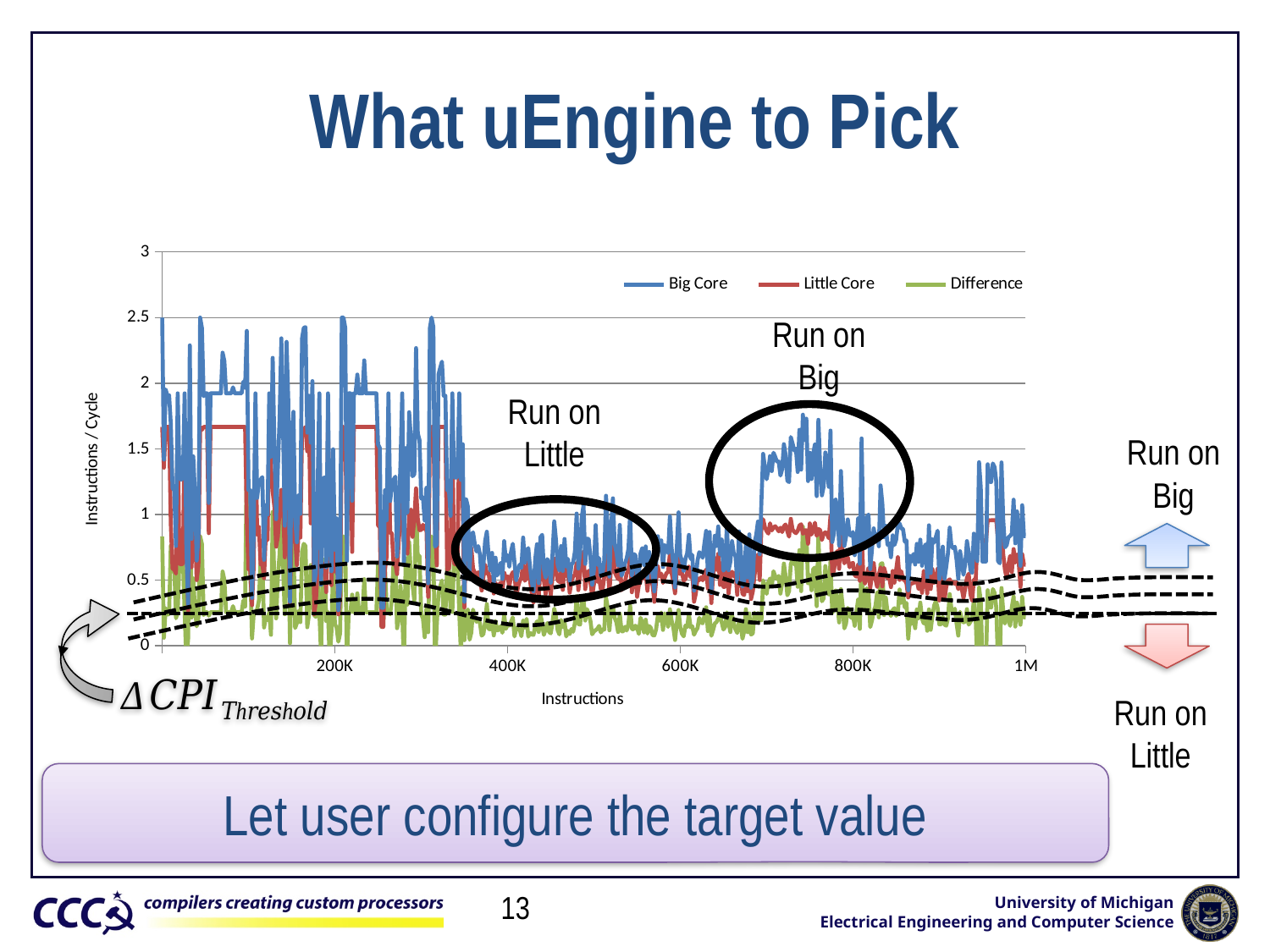
Around 750K instructions, which series has the larger value, Big Core or Little Core? Big Core Around 750K instructions, which series has the larger value, Big Core or Difference? Big Core Around 750K instructions, is the Big Core value greater or less than 1? greater What kind of chart is shown on the slide? Line chart What is the highest tick value shown on the chart's y axis? 3 What is the label of the chart's y axis? Instructions / Cycle Around 450K instructions, is the Big Core value greater or less than 1.5? less Around 450K instructions, is the Little Core value greater or less than 1? less What are the three series named in the chart's legend? Big Core, Little Core, Difference How many series does the chart's legend list? 3